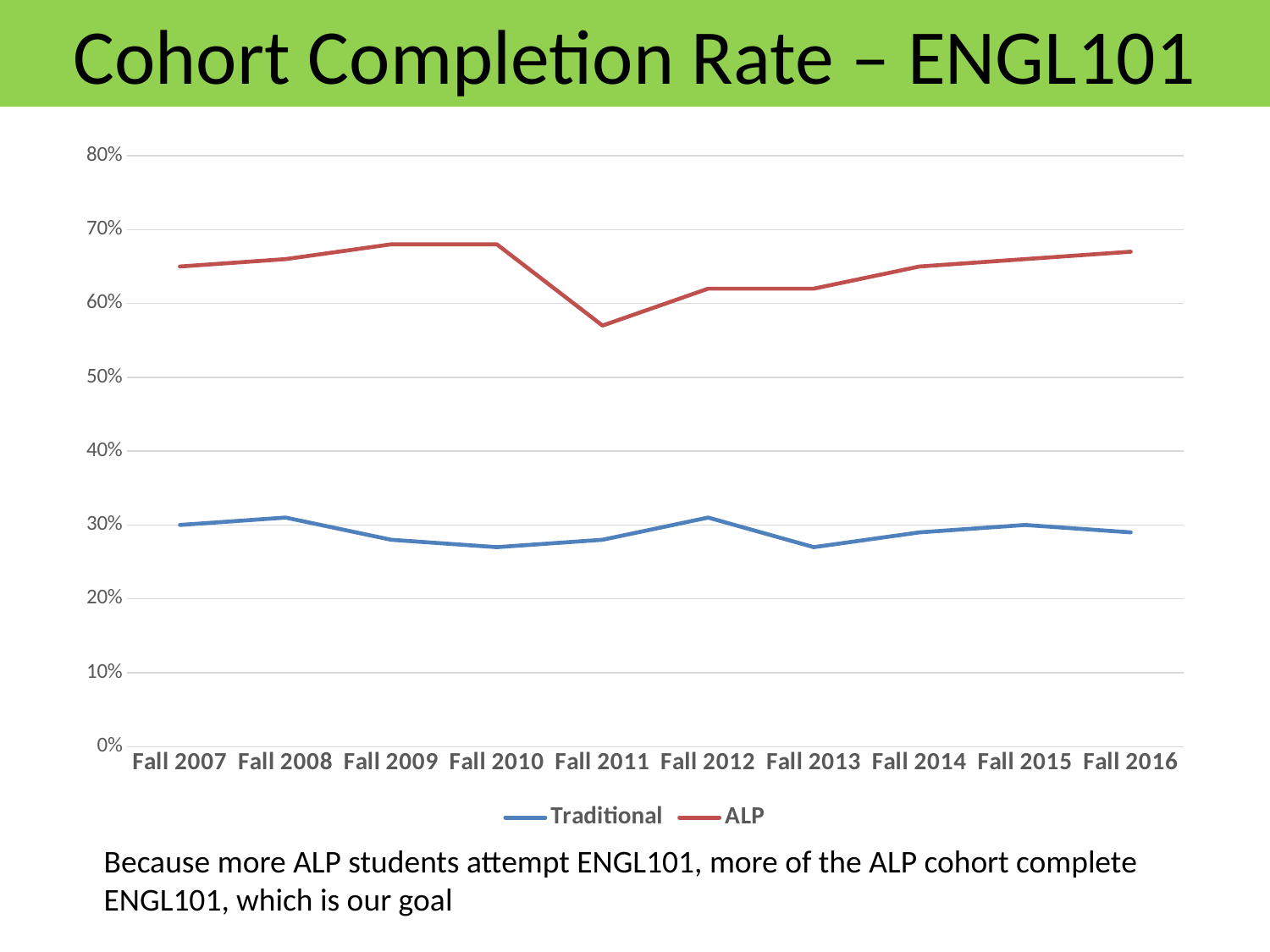
In which cohort is the ALP completion rate lowest? Fall 2011 Does the ALP completion rate rise or fall from Fall 2011 to Fall 2016? Rise How many series does the legend list? 2 Is the Traditional value for Fall 2010 greater or less than 30%? less What colour is the line for the ALP series? Red What kind of chart is shown on the slide? Line chart Is the ALP value for Fall 2009 greater or less than 60%? greater For the ALP series, which is larger: the value for Fall 2010 or the value for Fall 2011? Fall 2010 Is the ALP value for Fall 2016 greater or less than 70%? less How many cohorts (x-axis categories) are plotted on the chart? 10 Which series has the higher completion rate in Fall 2014, Traditional or ALP? ALP